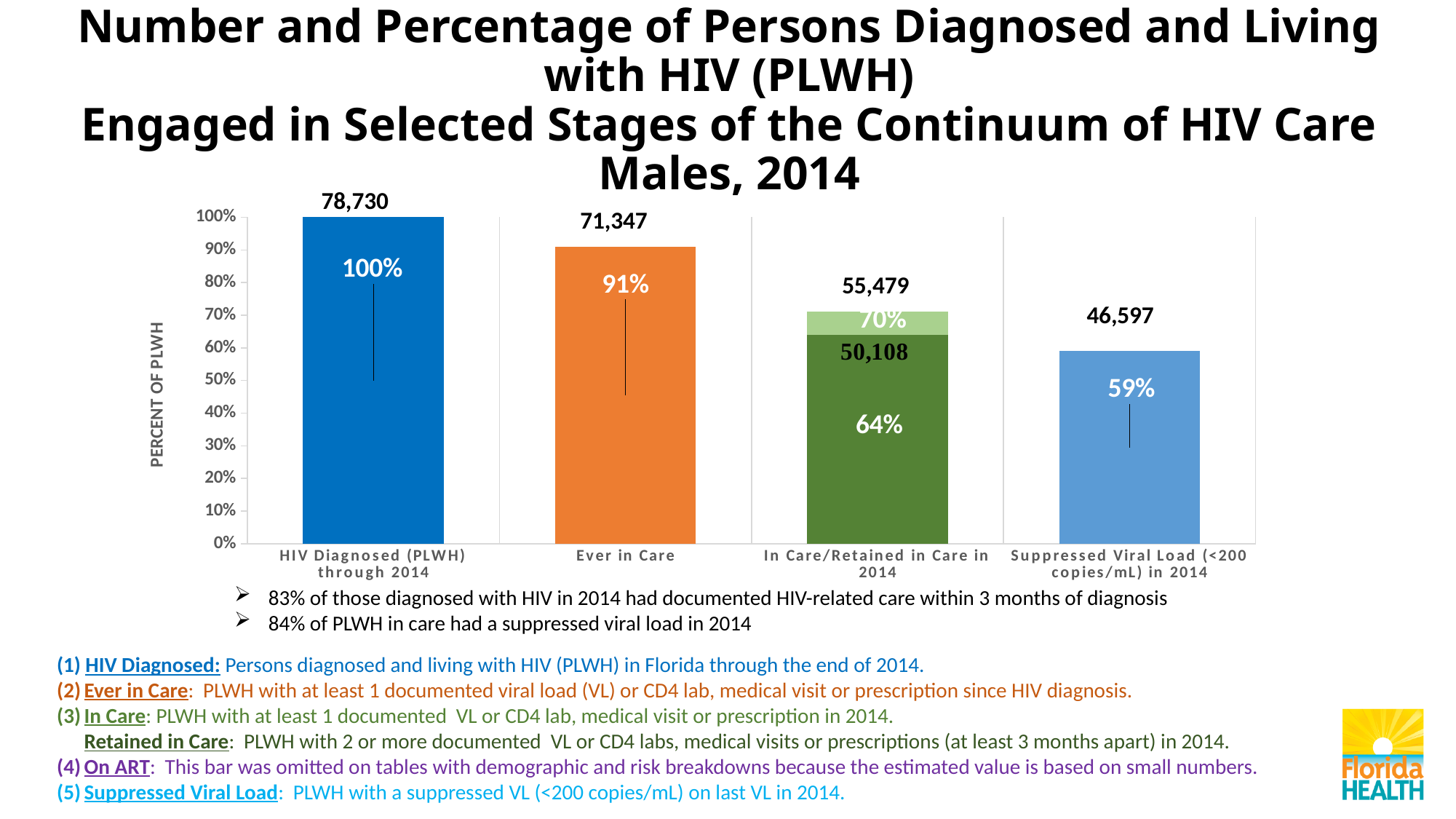
Which category has the highest number of persons? HIV Diagnosed (PLWH) through 2014 Do the percentages rise or fall moving from left to right across the categories? Fall What percentage is shown on the Ever in Care bar? 91% Which is larger: the number for Ever in Care or the number for Suppressed Viral Load (<200 copies/mL) in 2014? Ever in Care What kind of chart is shown on the slide? Bar chart What percentage is shown on the Suppressed Viral Load (<200 copies/mL) in 2014 bar? 59% What is the difference in number of persons between HIV Diagnosed (PLWH) through 2014 and Ever in Care? 7,383 What number is labeled at the top of the In Care/Retained in Care in 2014 bar? 55,479 What number is labeled on the darker green Retained in Care portion of the In Care/Retained in Care in 2014 bar? 50,108 Which category has the lowest percentage of PLWH? Suppressed Viral Load (<200 copies/mL) in 2014 How many categories are shown on the x axis of the chart? 4 What number is labeled on the bar for HIV Diagnosed (PLWH) through 2014? 78,730